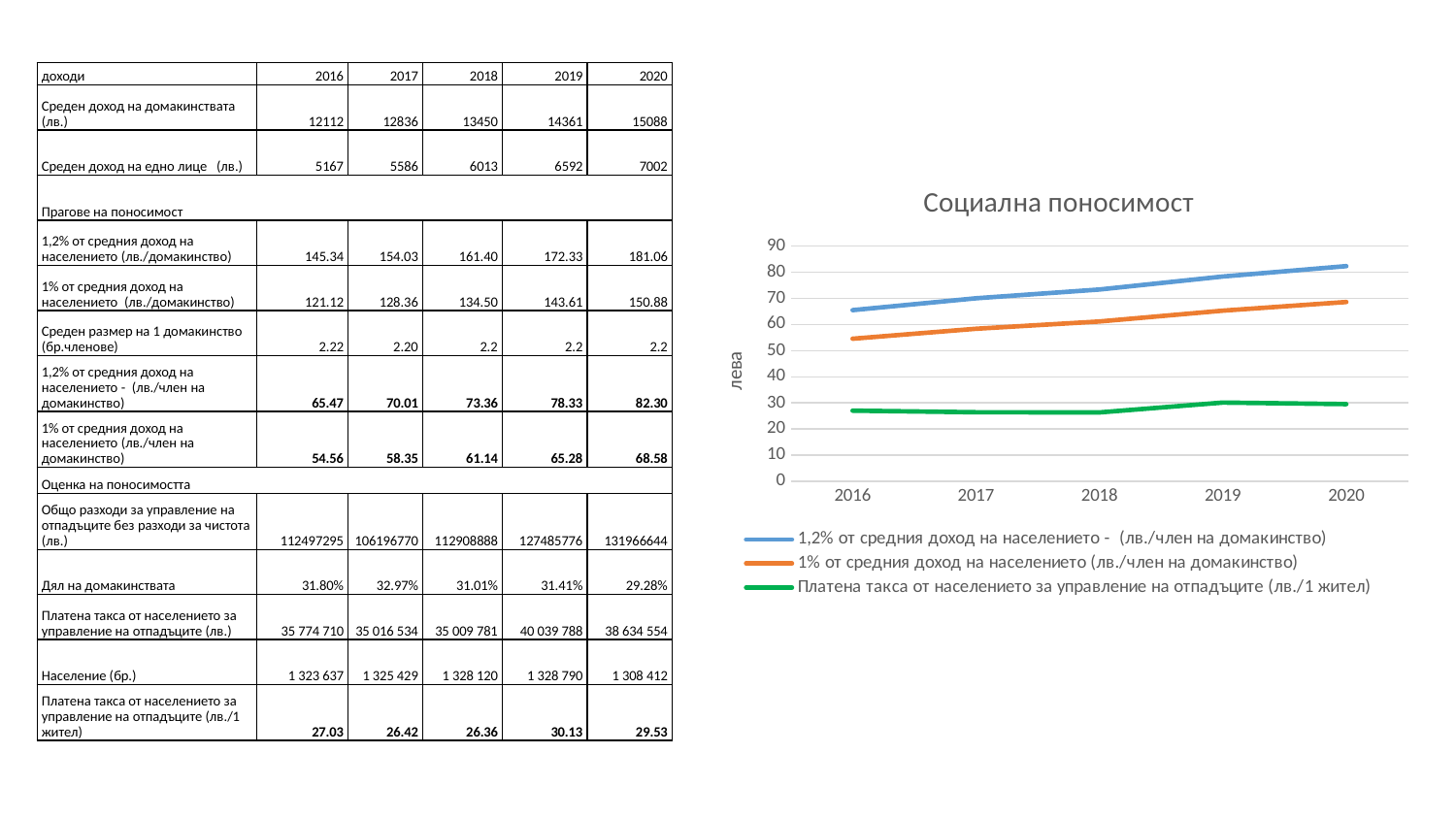
Does the series '1,2% от средния доход на населението - (лв./член на домакинство)' rise or fall from 2016 to 2020? rise In which year does the series '1,2% от средния доход на населението - (лв./член на домакинство)' reach its highest value? 2020 Is the 2018 value for 'Платена такса от населението за управление на отпадъците (лв./1 жител)' greater or less than 30? less How many series does the legend of the chart list? 3 What is the 2020 value for '1,2% от средния доход на населението - (лв./член на домакинство)', as printed in the table? 82.30 In 2020, which is larger: the 1,2% series or the 1% series? the 1,2% series What is the 2019 value for 'Платена такса от населението за управление на отпадъците (лв./1 жител)', as printed in the table? 30.13 What is the label on the y axis of the chart? лева What kind of chart is shown on the slide? line chart Is the 2016 value for '1,2% от средния доход на населението - (лв./член на домакинство)' greater or less than 60? greater How many years are plotted along the x axis of the chart? 5 What is the title of the chart? Социална поносимост